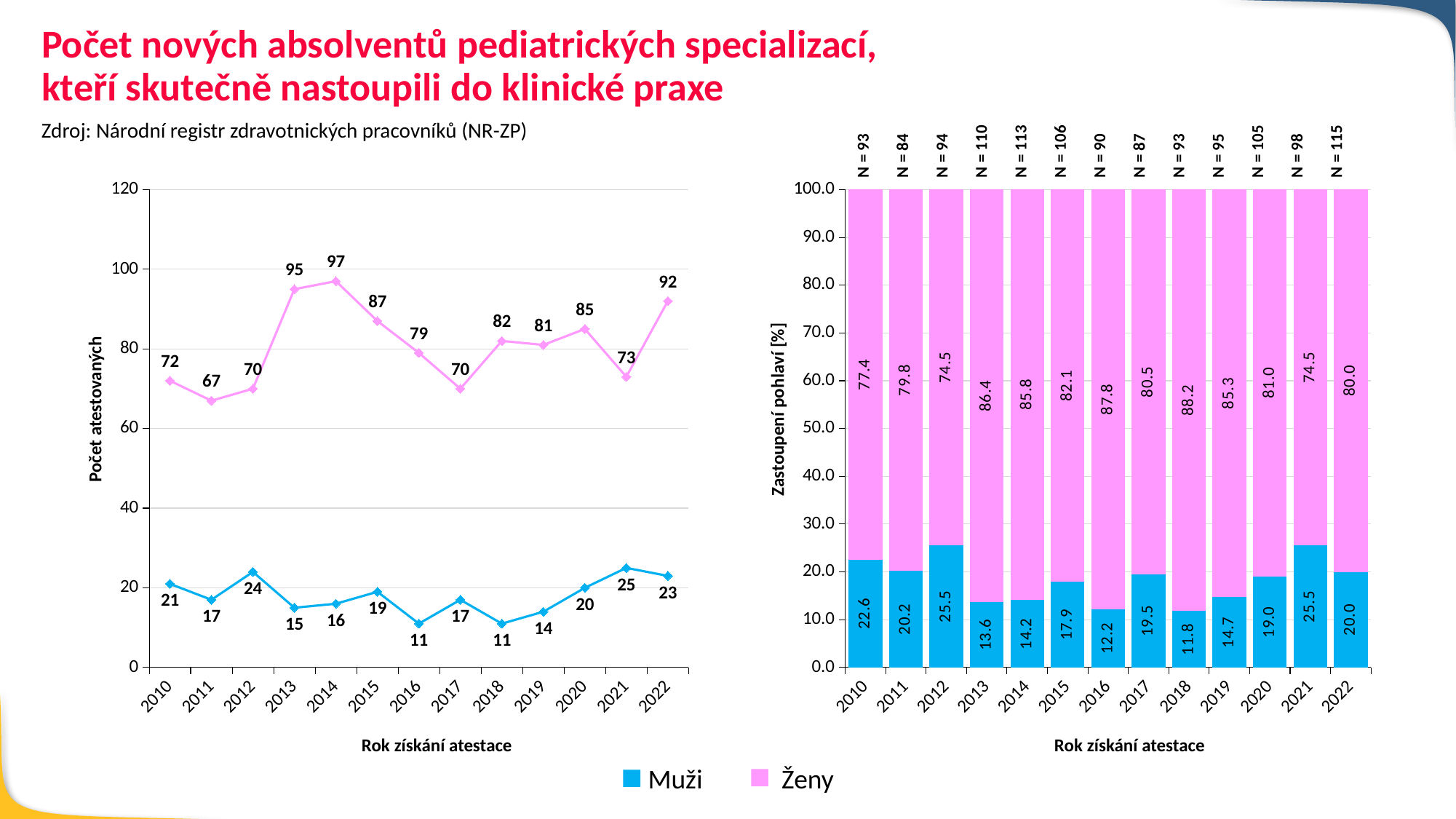
In the right stacked bar chart, what is the Muži share in 2013? 13.6 In the right stacked bar chart, what is the N value shown above the 2022 bar? N = 115 In the right stacked bar chart, what is the Ženy share in 2018? 88.2 In the left line chart, what is the value for Ženy in 2014? 97 In the left line chart, in which year is the Ženy series highest? 2014 In the left line chart, which is larger: the Ženy value in 2013 or the Ženy value in 2018? 2013 In the left line chart, how many years are shown on the x axis? 13 How many series does the legend list? 2 In the left line chart, what is the difference between the Ženy and Muži values in 2022? 69 In the left line chart, in which year is the Muži series highest? 2021 In the left line chart, what is the value for Muži in 2016? 11 What kind of chart is the chart on the left? line chart